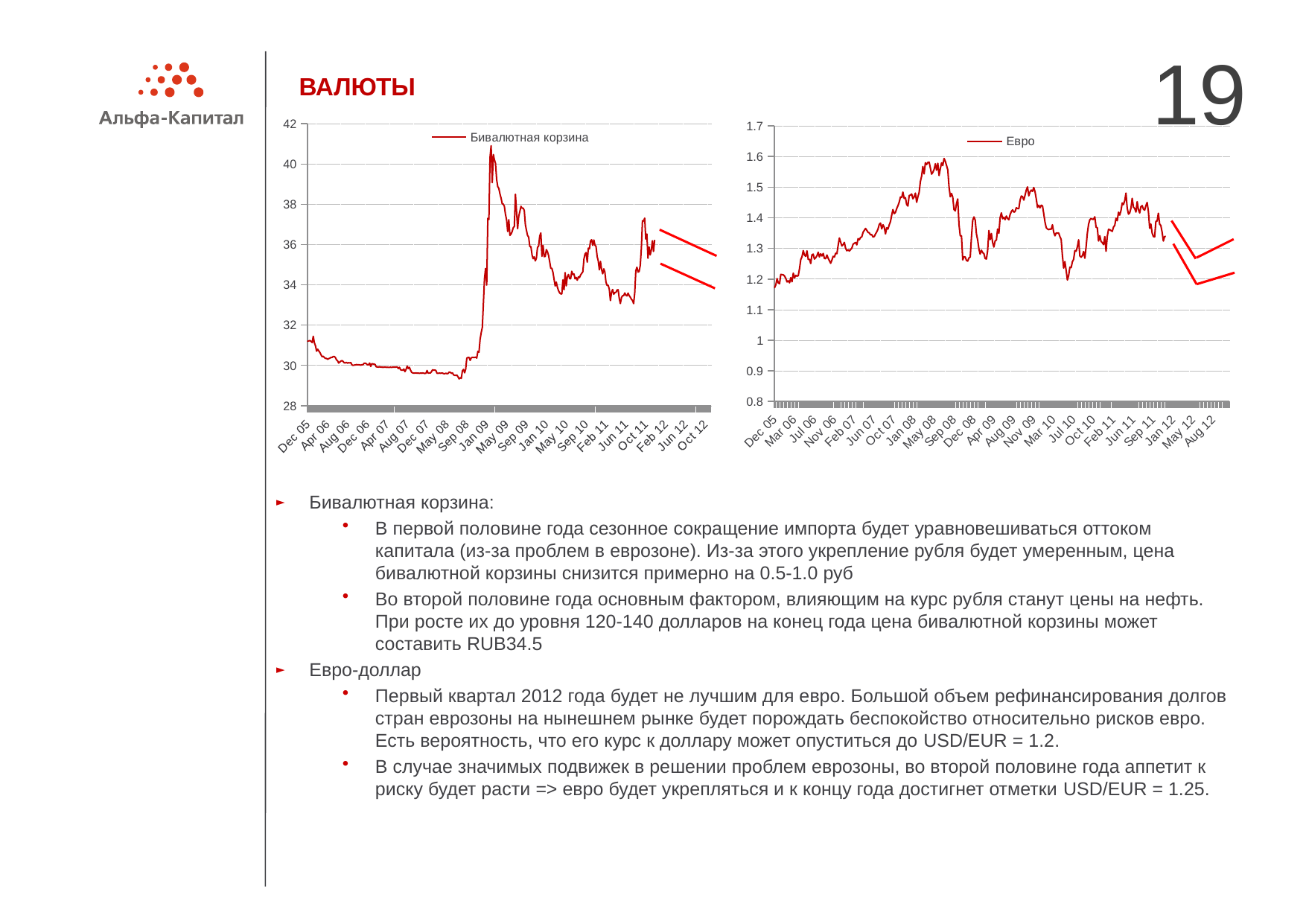
What is the name of the series shown in the legend of the right chart? Евро What colour is the line in the left chart (Бивалютная корзина)? red In the right chart (Евро), does the line rise or fall between Dec 05 and May 08? rise In the right chart (Евро), is the value at Dec 05 greater or less than 1.3? less What kind of chart is the left chart, titled 'Бивалютная корзина' in its legend? line chart What kind of chart is the right chart, titled 'Евро' in its legend? line chart In the left chart (Бивалютная корзина), is the value at Dec 05 greater or less than 30? greater In the right chart (Евро), is the peak value around May 08 greater or less than 1.5? greater How many series does the legend of the left chart list? 1 How many series does the legend of the right chart list? 1